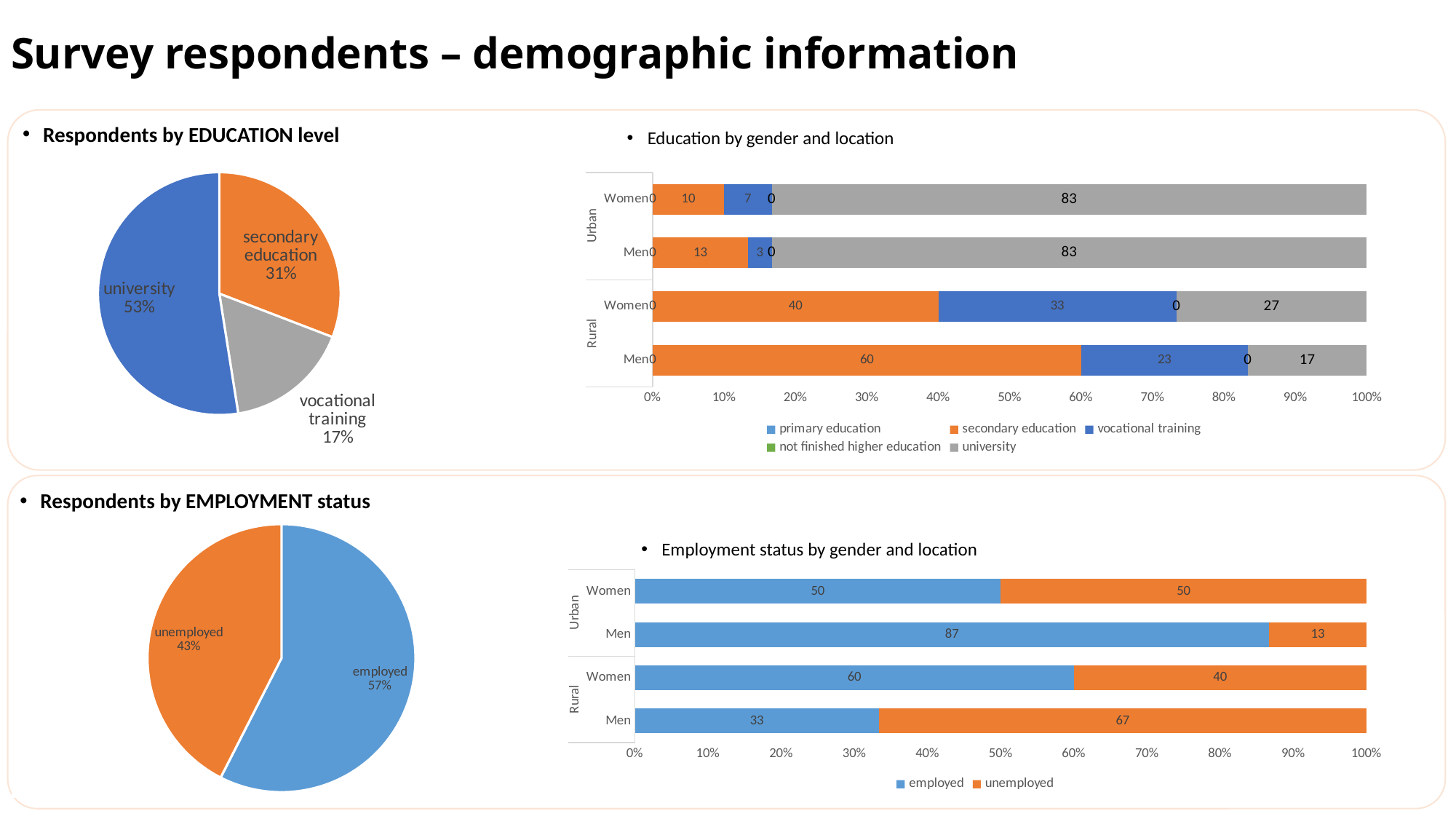
In the 'Respondents by EDUCATION level' pie chart, what is the difference in percentage points between the university and secondary education shares? 22 In the 'Education by gender and location' chart, what is the secondary education value for Rural Men? 60 What kind of chart is 'Education by gender and location'? stacked bar chart In the 'Employment status by gender and location' chart, what is the employed value for Urban Men? 87 In the 'Employment status by gender and location' chart, which group has the lowest employed value? Rural Men In the 'Education by gender and location' chart, what is the university value for Urban Women? 83 In the 'Respondents by EMPLOYMENT status' pie chart, what share of respondents are unemployed? 43% In the 'Respondents by EDUCATION level' pie chart, what share of respondents have a university education? 53% In the 'Education by gender and location' chart, which group has the highest vocational training value? Rural Women How many series does the legend of the 'Education by gender and location' chart list? 5 In the 'Respondents by EDUCATION level' pie chart, which education level has the smallest share? vocational training In the 'Employment status by gender and location' chart, is the unemployed value for Rural Women larger or smaller than the unemployed value for Urban Men? larger